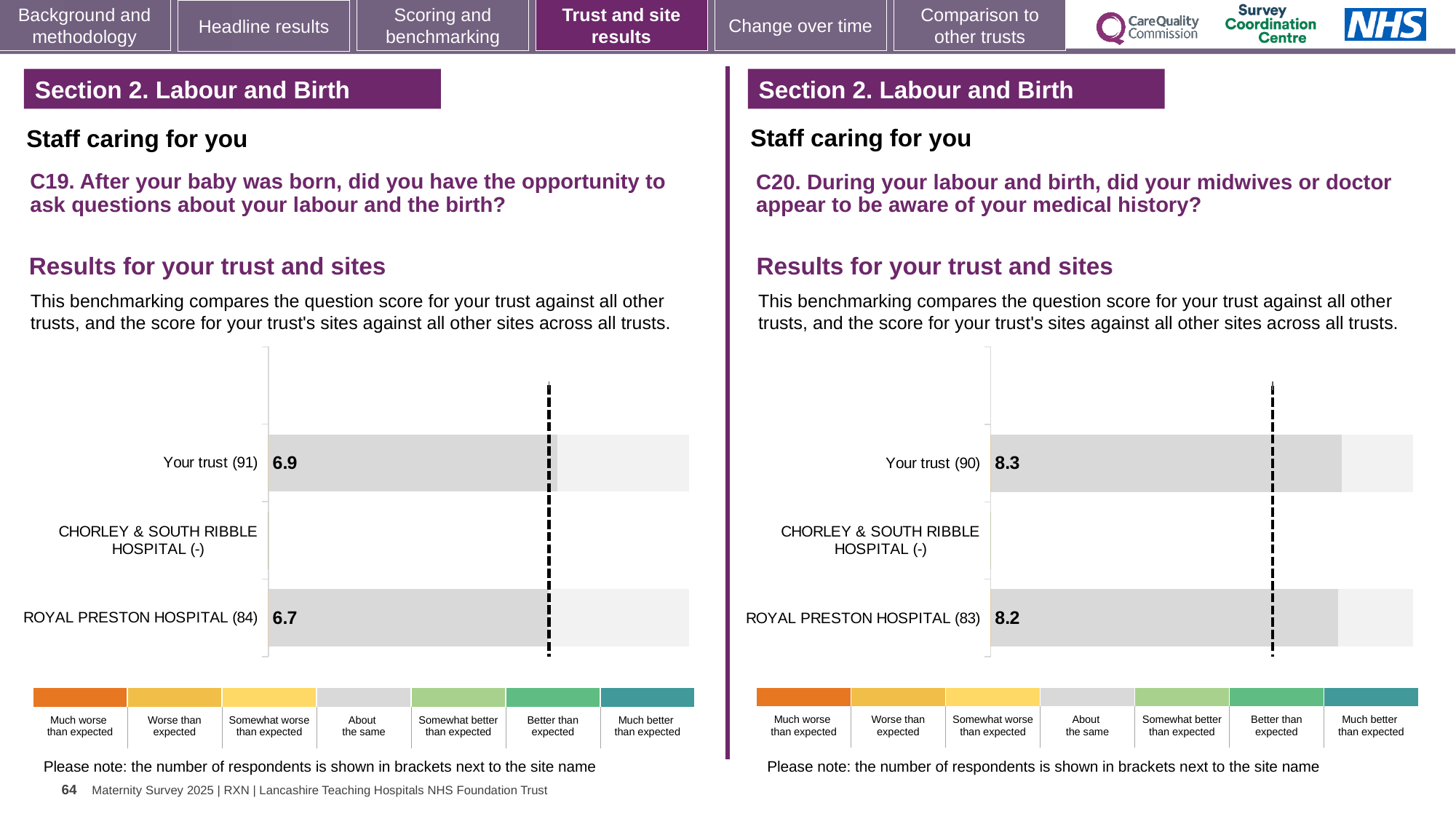
On the C19 chart (left), which has the higher score, Your trust or ROYAL PRESTON HOSPITAL? Your trust On the C19 chart (left), what is the score for Your trust? 6.9 How many site/trust rows are listed on the C20 chart (right)? 3 On the C19 chart (left), what is the difference between the Your trust score and the ROYAL PRESTON HOSPITAL score? 0.2 On the C19 chart (left), which row has no bar plotted? CHORLEY & SOUTH RIBBLE HOSPITAL (-) On the C20 chart (right), what is the score for Your trust? 8.3 On the C19 chart (left), how many respondents are shown in brackets for ROYAL PRESTON HOSPITAL? 84 On the C19 chart (left), what is the score for ROYAL PRESTON HOSPITAL? 6.7 On the C20 chart (right), what is the score for ROYAL PRESTON HOSPITAL? 8.2 On the C20 chart (right), what is the difference between the Your trust score and the ROYAL PRESTON HOSPITAL score? 0.1 What kind of chart is used on the C19 chart (left)? Bar chart On the C20 chart (right), how many respondents are shown in brackets for Your trust? 90